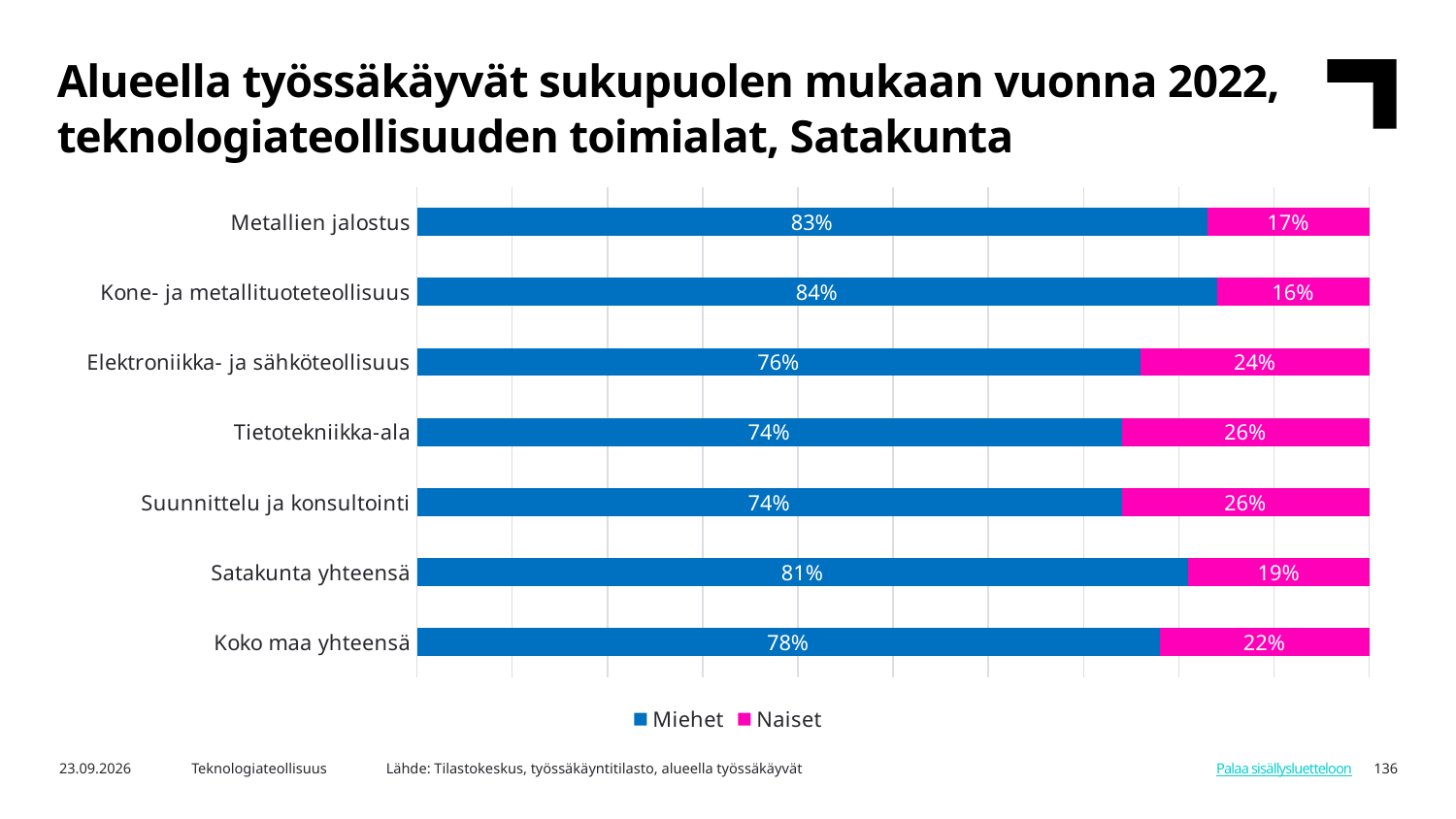
Which category has the lowest Naiset share? Kone- ja metallituoteteollisuus What is the total of the stacked bar for Suunnittelu ja konsultointi? 100% What kind of chart is shown on the slide? Stacked bar chart What is the Naiset share for Elektroniikka- ja sähköteollisuus? 24% How many series does the legend list? 2 What is the Miehet share for Satakunta yhteensä? 81% Which category has the highest Miehet share? Kone- ja metallituoteteollisuus Which is larger: the Naiset share for Satakunta yhteensä or for Koko maa yhteensä? Koko maa yhteensä What is the Naiset share for Koko maa yhteensä? 22% What is the difference between the Miehet share for Kone- ja metallituoteteollisuus and for Tietotekniikka-ala? 10 percentage points What is the Miehet share for Metallien jalostus? 83% How many categories are shown on the chart? 7